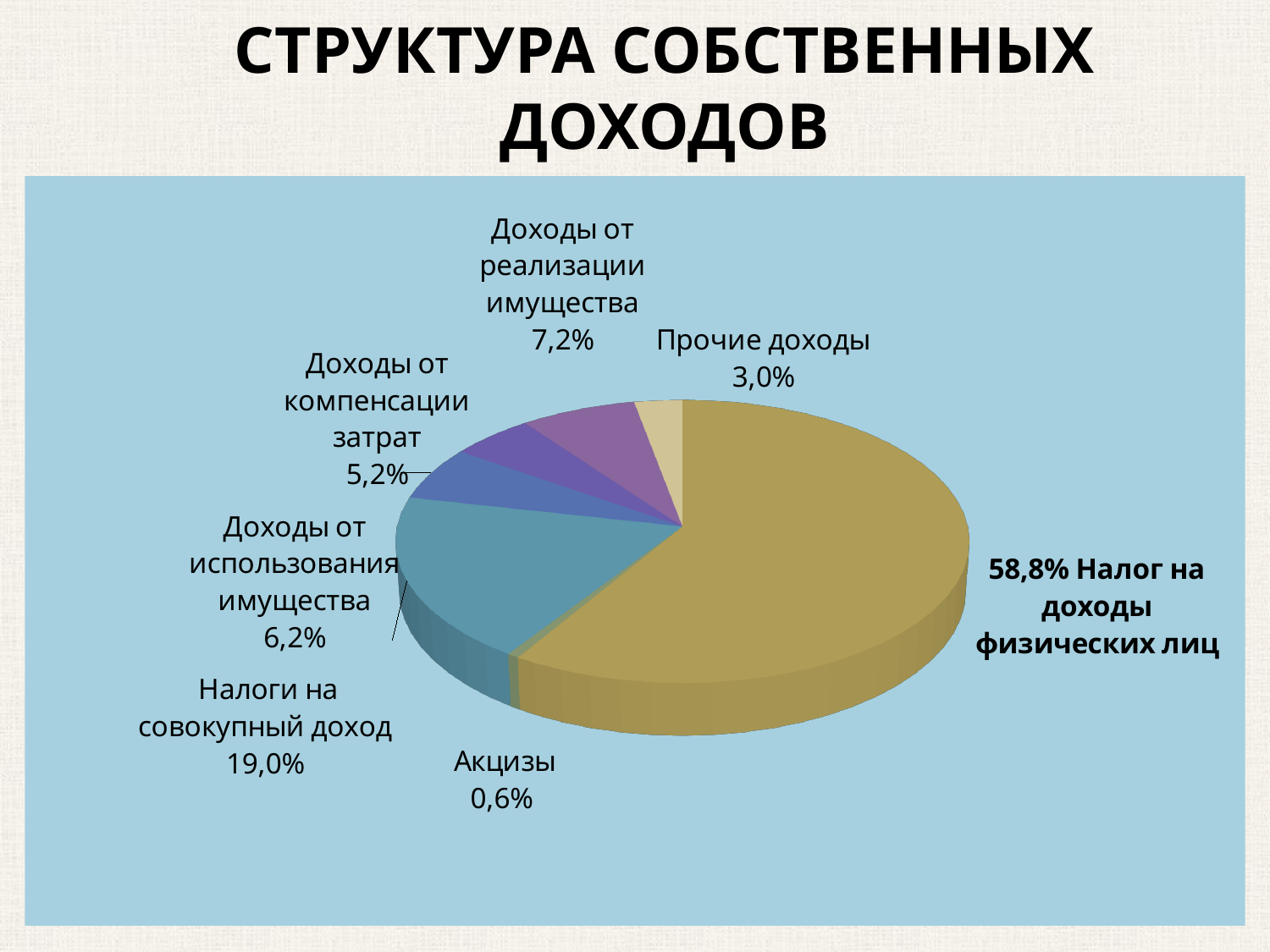
Which category has the smallest share of the pie? Акцизы What is the title of the slide containing the chart? СТРУКТУРА СОБСТВЕННЫХ ДОХОДОВ Which is larger: "Доходы от использования имущества" or "Доходы от компенсации затрат"? Доходы от использования имущества What is the value shown for "Налоги на совокупный доход"? 19,0% How many slices does the pie chart have? 7 Which category has the largest share of the pie? Налог на доходы физических лиц What type of chart is shown on the slide? Pie chart What share of the pie does "Налог на доходы физических лиц" have? 58,8% What is the difference between the shares of "Налог на доходы физических лиц" and "Налоги на совокупный доход"? 39,8% What is the value shown for "Доходы от реализации имущества"? 7,2% What is the value shown for "Акцизы"? 0,6% What is the value shown for "Прочие доходы"? 3,0%